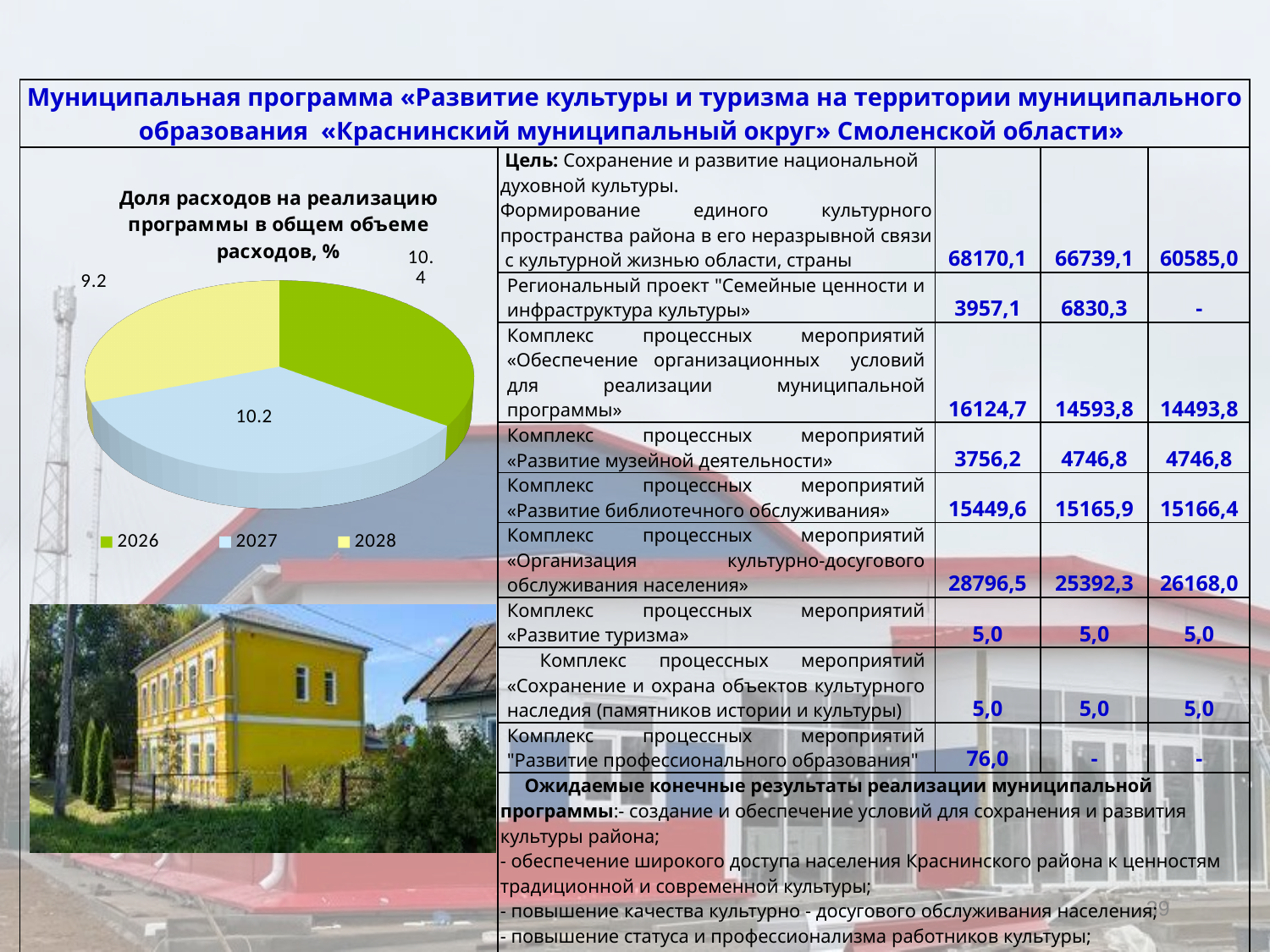
What is the value shown for 2027 in the pie chart? 10.2 What is the value shown for 2028 in the pie chart? 9.2 What type of chart is shown on the slide? Pie chart What is the difference between the values for 2026 and 2028 in the pie chart? 1.2 Which colour represents 2028 in the pie chart? Yellow What is the difference between the values for 2027 and 2028 in the pie chart? 1.0 Which year has the largest slice in the pie chart? 2026 Which is larger in the pie chart, the value for 2026 or the value for 2027? 2026 How many entries does the legend of the pie chart list? 3 How many slices does the pie chart have? 3 What is the value shown for 2026 in the pie chart? 10.4 Which year has the smallest slice in the pie chart? 2028